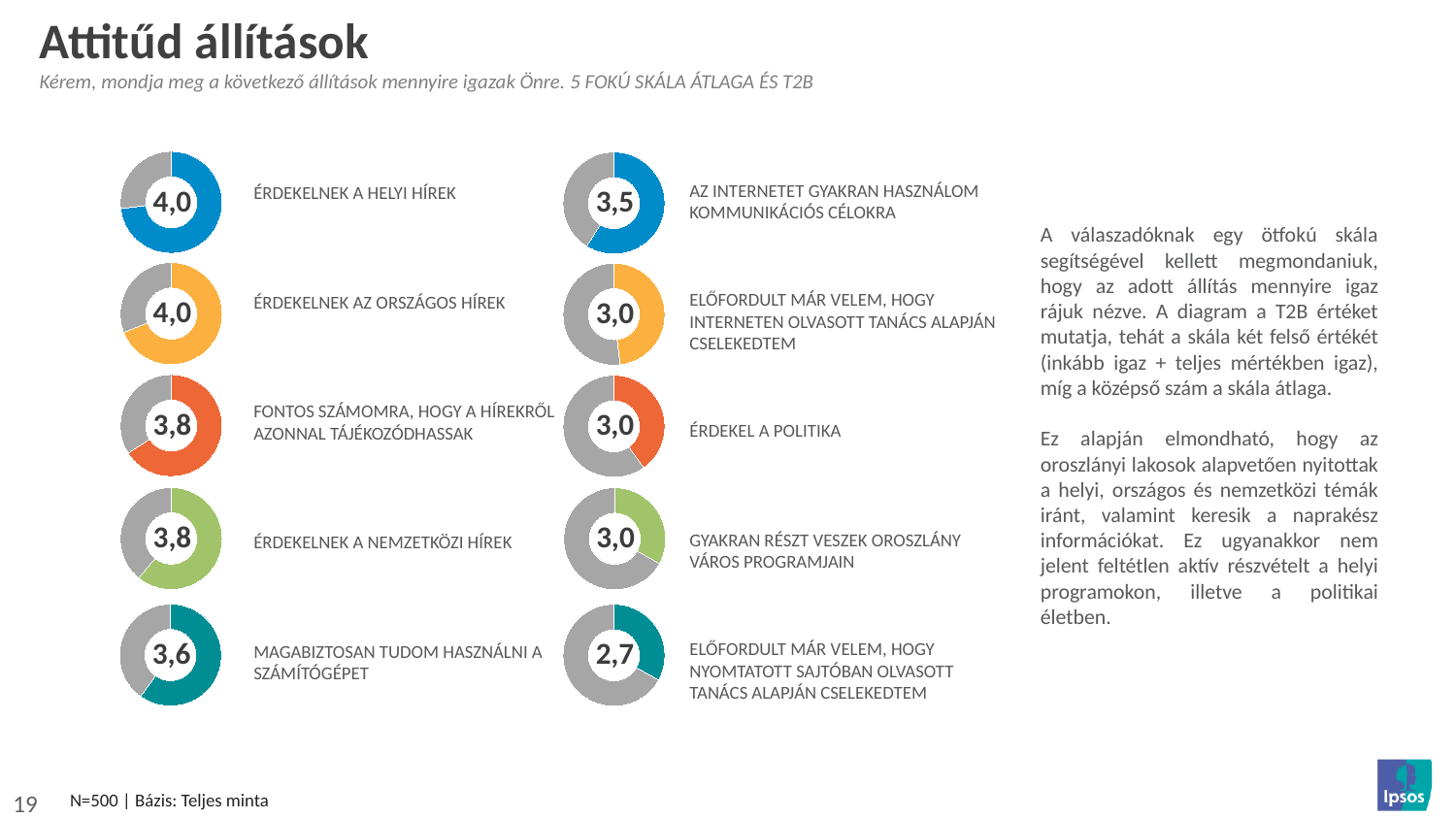
What kind of chart is used to display each statement's value on the slide? Donut (pie) chart What is the title of the slide? Attitűd állítások What value is shown in the centre of the donut chart labelled "AZ INTERNETET GYAKRAN HASZNÁLOM KOMMUNIKÁCIÓS CÉLOKRA"? 3,5 What value is shown in the centre of the donut chart labelled "MAGABIZTOSAN TUDOM HASZNÁLNI A SZÁMÍTÓGÉPET"? 3,6 What is the difference between the value for "ÉRDEKELNEK AZ ORSZÁGOS HÍREK" and the value for "ELŐFORDULT MÁR VELEM, HOGY NYOMTATOTT SAJTÓBAN OLVASOTT TANÁCS ALAPJÁN CSELEKEDTEM"? 1,3 How many donut charts are shown on the slide? 10 What value is shown in the centre of the donut chart labelled "ÉRDEKEL A POLITIKA"? 3,0 What value is shown in the centre of the donut chart labelled "ÉRDEKELNEK A HELYI HÍREK"? 4,0 What is the highest average value shown in any of the donut charts on the slide? 4,0 Which has the larger value: "FONTOS SZÁMOMRA, HOGY A HÍREKRŐL AZONNAL TÁJÉKOZÓDHASSAK" or "GYAKRAN RÉSZT VESZEK OROSZLÁNY VÁROS PROGRAMJAIN"? FONTOS SZÁMOMRA, HOGY A HÍREKRŐL AZONNAL TÁJÉKOZÓDHASSAK Which statement has the lowest average value shown on the slide? ELŐFORDULT MÁR VELEM, HOGY NYOMTATOTT SAJTÓBAN OLVASOTT TANÁCS ALAPJÁN CSELEKEDTEM What value is shown in the centre of the donut chart labelled "ELŐFORDULT MÁR VELEM, HOGY NYOMTATOTT SAJTÓBAN OLVASOTT TANÁCS ALAPJÁN CSELEKEDTEM"? 2,7